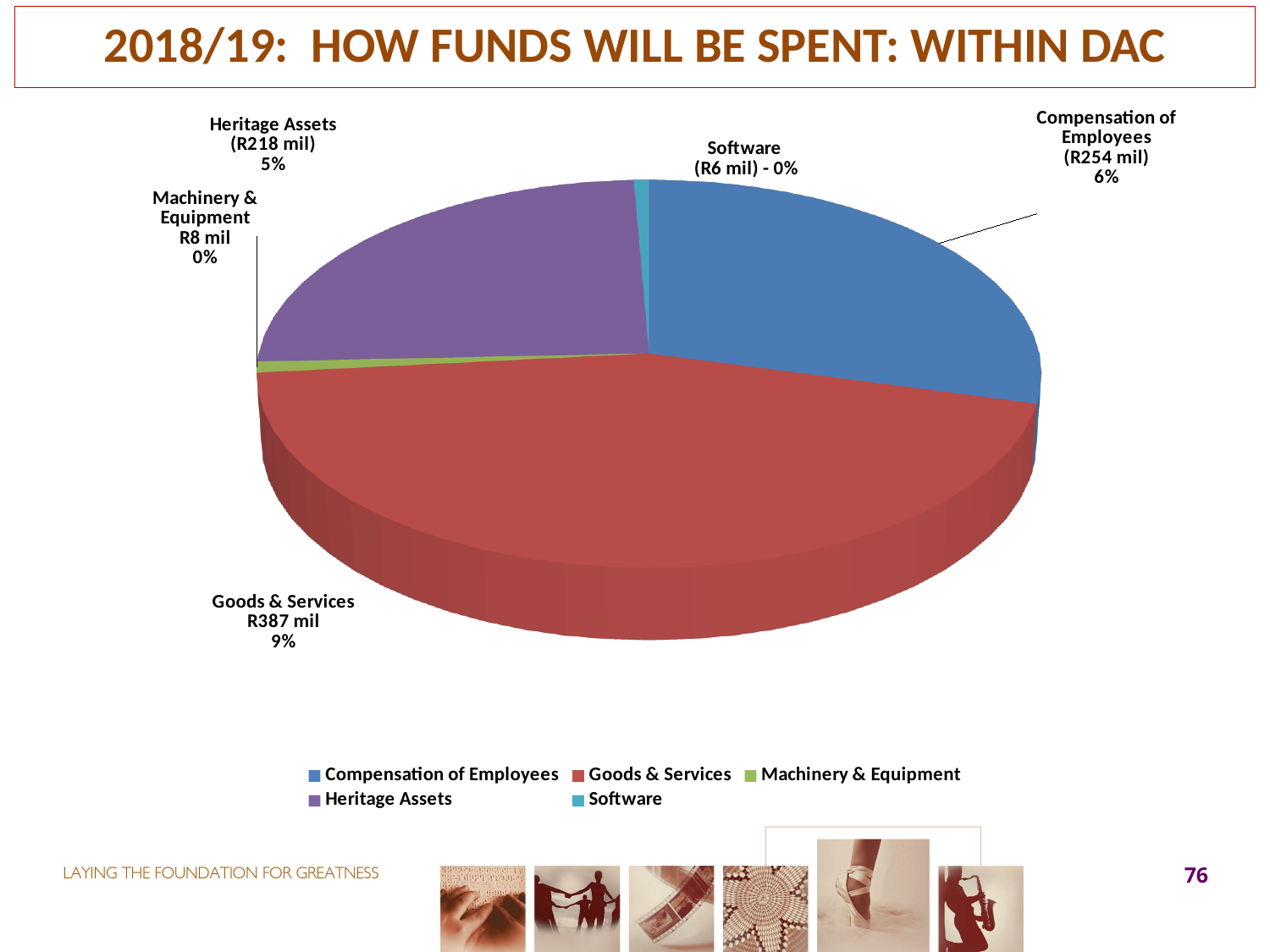
What is the difference in rand between Goods & Services and Compensation of Employees? R133 mil What percentage is shown for Software? 0% What amount is shown for Goods & Services? R387 mil Which category has the smallest amount in rand? Software What amount is shown for Compensation of Employees? R254 mil What amount is shown for Heritage Assets? R218 mil What amount is shown for Machinery & Equipment? R8 mil What percentage is shown for Goods & Services? 9% How many categories does the pie chart show? 5 What kind of chart is shown on the slide? pie chart How many entries does the legend list? 5 Which category has the largest slice of the pie? Goods & Services